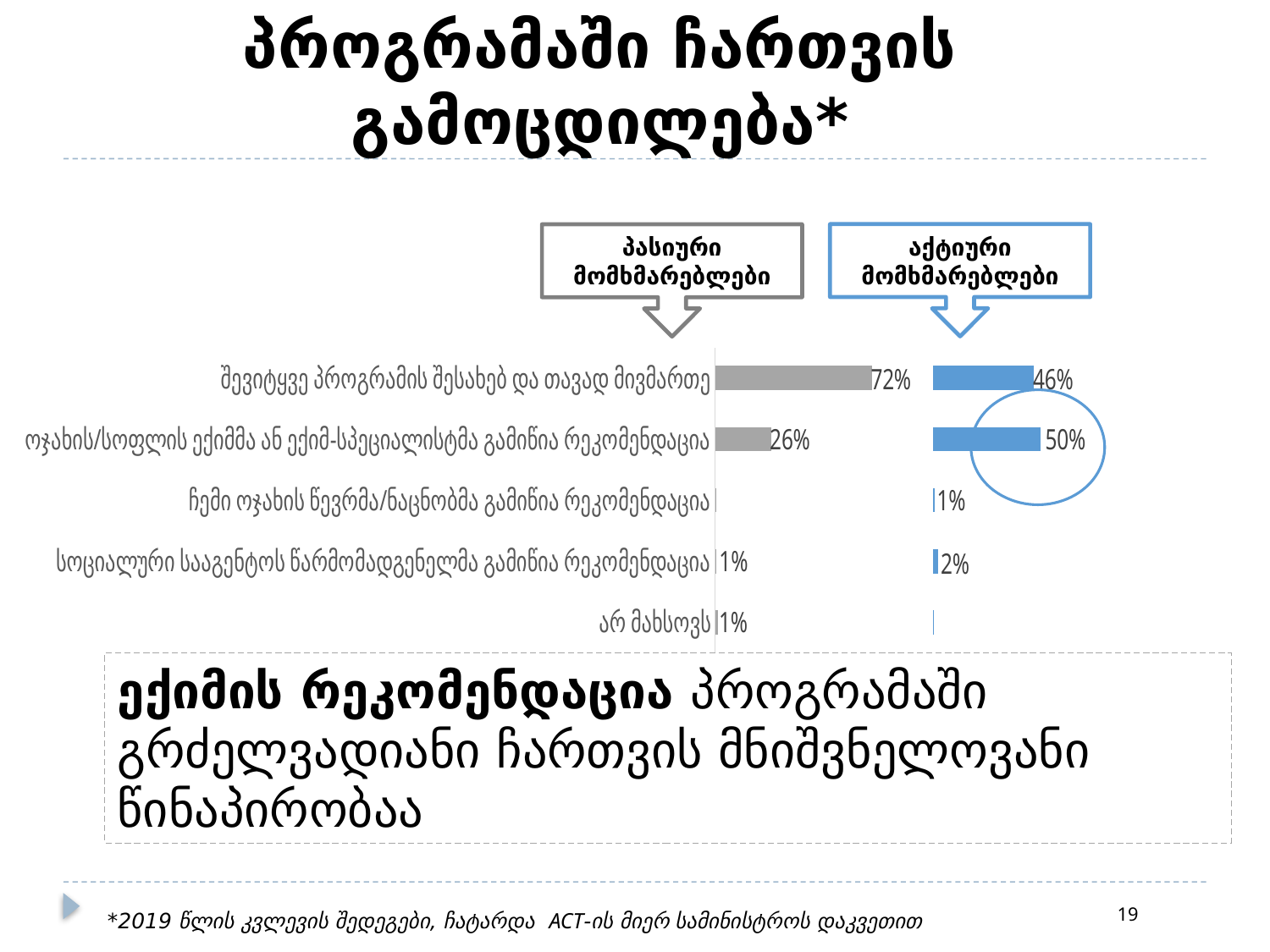
For "ოჯახის/სოფლის ექიმმა ან ექიმ-სპეციალისტმა გამიწია რეკომენდაცია", which series has the larger value: "პასიური მომხმარებლები" or "აქტიური მომხმარებლები"? აქტიური მომხმარებლები How many series does the chart show? 2 What is the value for "სოციალური სააგენტოს წარმომადგენელმა გამიწია რეკომენდაცია" in the "აქტიური მომხმარებლები" series? 2% What is the value for "შევიტყვე პროგრამის შესახებ და თავად მივმართე" in the "პასიური მომხმარებლები" series? 72% Which category has the highest value in the "აქტიური მომხმარებლები" series? ოჯახის/სოფლის ექიმმა ან ექიმ-სპეციალისტმა გამიწია რეკომენდაცია What is the value for "ოჯახის/სოფლის ექიმმა ან ექიმ-სპეციალისტმა გამიწია რეკომენდაცია" in the "პასიური მომხმარებლები" series? 26% What is the value for "შევიტყვე პროგრამის შესახებ და თავად მივმართე" in the "აქტიური მომხმარებლები" series? 46% What kind of chart is shown on the slide? bar chart What is the value for "ოჯახის/სოფლის ექიმმა ან ექიმ-სპეციალისტმა გამიწია რეკომენდაცია" in the "აქტიური მომხმარებლები" series? 50% What is the difference between the "პასიური მომხმარებლები" and "აქტიური მომხმარებლები" values for "შევიტყვე პროგრამის შესახებ და თავად მივმართე"? 26% How many categories are shown in the chart? 5 Which category has the highest value in the "პასიური მომხმარებლები" series? შევიტყვე პროგრამის შესახებ და თავად მივმართე